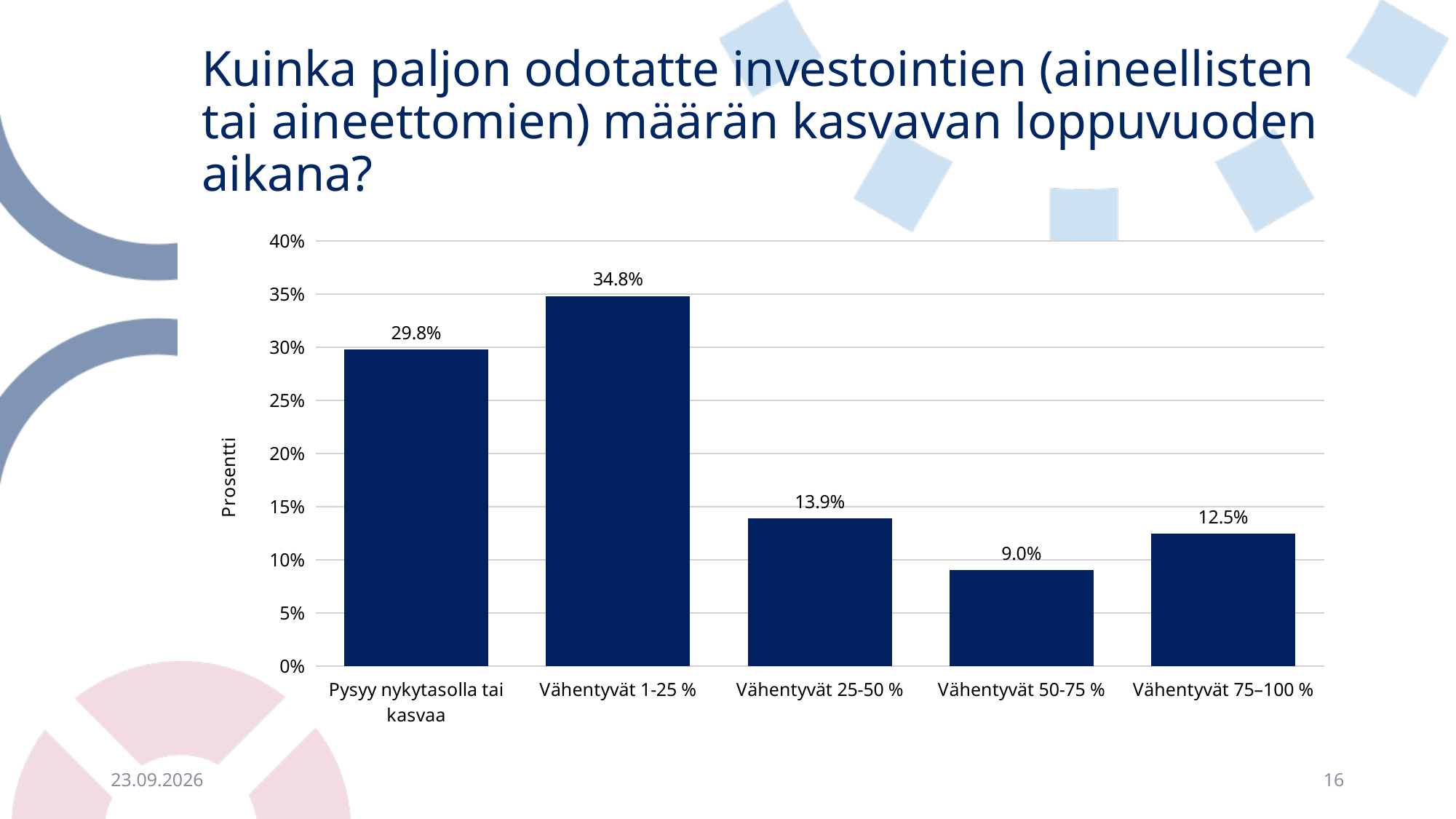
What is the value for "Vähentyvät 50-75 %"? 9.0% What is the value for "Vähentyvät 1-25 %"? 34.8% What kind of chart is shown on the slide? bar chart Which is larger, the value for "Vähentyvät 25-50 %" or the value for "Vähentyvät 75–100 %"? Vähentyvät 25-50 % What is the label of the vertical axis? Prosentti What is the difference between the values for "Vähentyvät 25-50 %" and "Vähentyvät 75–100 %"? 1.4% What is the value for "Pysyy nykytasolla tai kasvaa"? 29.8% What is the difference between the values for "Vähentyvät 1-25 %" and "Pysyy nykytasolla tai kasvaa"? 5.0% Which category has the highest value? Vähentyvät 1-25 % Which category has the lowest value? Vähentyvät 50-75 % How many categories are shown on the x axis? 5 Is the value for "Vähentyvät 50-75 %" greater or less than 10%? less